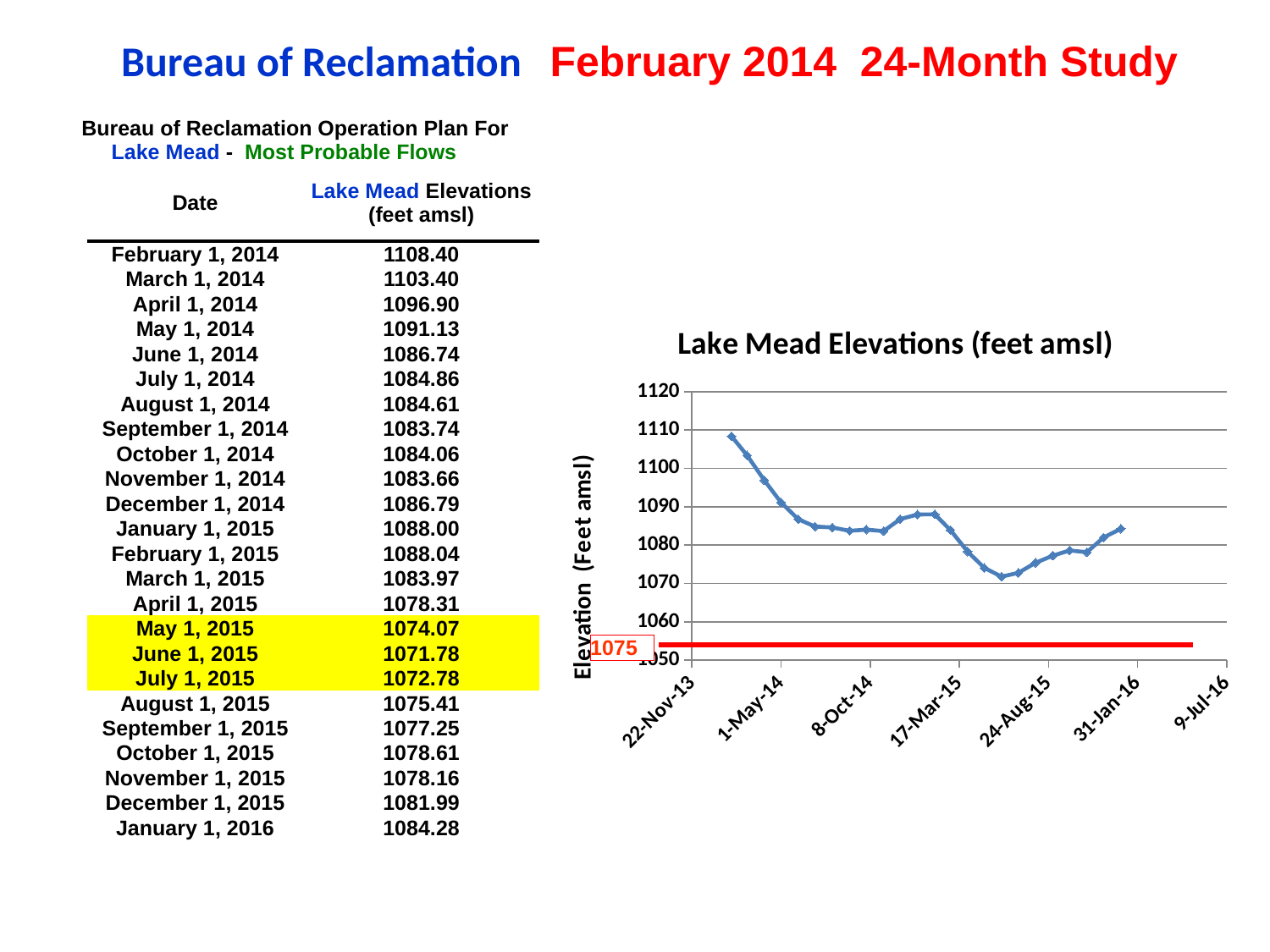
Does the Lake Mead elevation rise or fall from the start of the series to mid-2015? fall What is the difference between the elevation on February 1, 2014 and the elevation on January 1, 2016? 24.12 What is the title of the chart? Lake Mead Elevations (feet amsl) What is the lowest Lake Mead elevation plotted on the chart? 1071.78 What kind of chart is shown on the slide? line chart Is the first plotted elevation value greater or less than 1100? greater Is the lowest plotted elevation value greater or less than 1075? less What is the highest Lake Mead elevation plotted on the chart? 1108.40 On which date does the Lake Mead elevation reach its lowest value? June 1, 2015 What is the Lake Mead elevation on July 1, 2015? 1072.78 What elevation value is marked by the red horizontal line on the chart? 1075 How many data points are plotted on the chart? 24